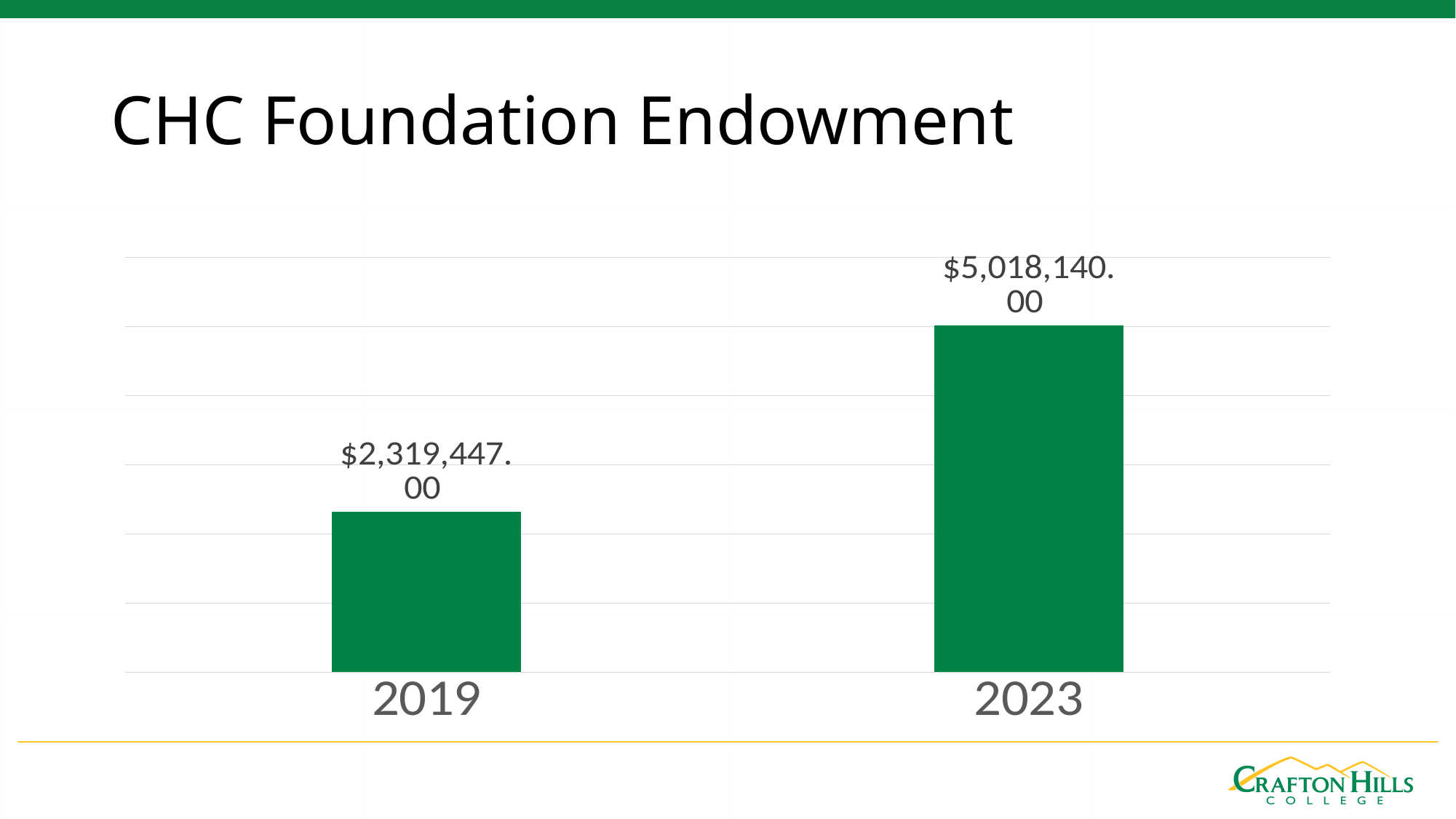
Which is larger, the value for 2019 or the value for 2023? 2023 What kind of chart is shown on the slide? Bar chart Do the values rise or fall from 2019 to 2023? Rise How many bars are shown in the chart? 2 What is the difference between the 2023 value and the 2019 value? $2,698,693.00 What is the value for 2023? $5,018,140.00 What is the value for 2019? $2,319,447.00 Which year has the lowest value? 2019 Which year has the highest value? 2023 What is the title of the slide containing the chart? CHC Foundation Endowment What colour are the bars in the chart? Green